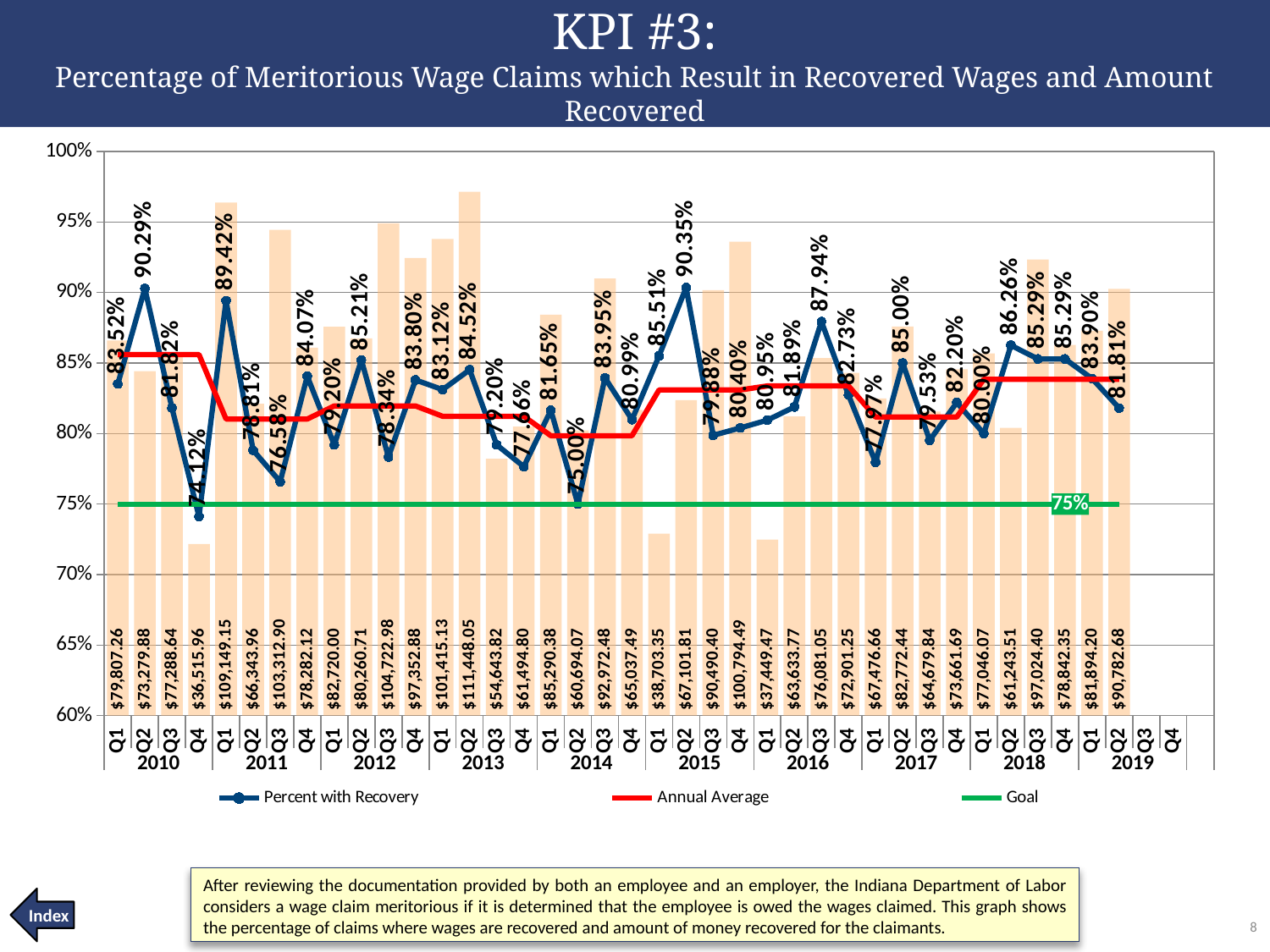
What is the Percent with Recovery for Q2 2015? 90.35% Which quarter has the highest Percent with Recovery? Q2 2015 Which quarter has the lowest Percent with Recovery? Q4 2010 What value is the Goal line set at? 75% What is the Percent with Recovery for Q4 2010? 74.12% What is the difference in Percent with Recovery between Q1 2019 and Q2 2019? 2.09 percentage points Which quarter has the lowest amount recovered? Q4 2010 Which is larger, the amount recovered in Q1 2011 or in Q3 2011? Q1 2011 What amount was recovered in Q2 2013? $111,448.05 How many series does the legend list? 3 Is the Percent with Recovery for Q2 2014 greater or less than 80%? less What is the Percent with Recovery for Q3 2016? 87.94%